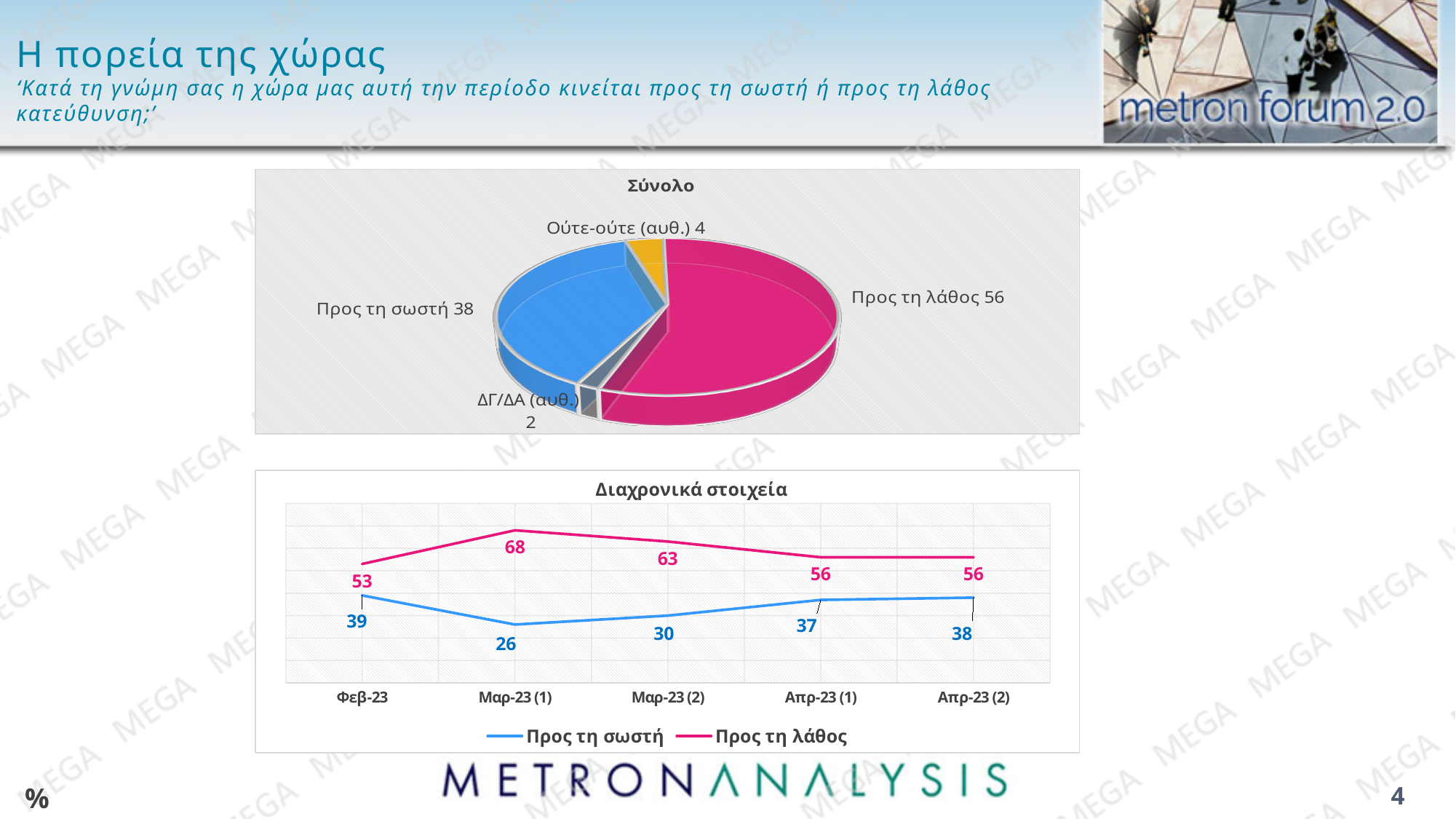
In the 'Διαχρονικά στοιχεία' chart, does 'Προς τη λάθος' rise or fall from Μαρ-23 (1) to Απρ-23 (2)? Fall In the 'Διαχρονικά στοιχεία' chart, what is the value for 'Προς τη λάθος' at Μαρ-23 (1)? 68 What kind of chart is the 'Διαχρονικά στοιχεία' chart? Line chart In the 'Διαχρονικά στοιχεία' chart, what is the difference between 'Προς τη λάθος' and 'Προς τη σωστή' at Φεβ-23? 14 What kind of chart is the 'Σύνολο' chart? Pie chart In the 'Διαχρονικά στοιχεία' chart, what is the value for 'Προς τη σωστή' at Μαρ-23 (2)? 30 In the 'Σύνολο' chart, which category has the smallest slice? ΔΓ/ΔΑ (αυθ.) In the 'Σύνολο' chart, what is the value for 'Προς τη σωστή'? 38 In the 'Σύνολο' chart, what is the value for 'Προς τη λάθος'? 56 In the 'Διαχρονικά στοιχεία' chart, how many series does the legend list? 2 In the 'Διαχρονικά στοιχεία' chart, at which point is 'Προς τη σωστή' lowest? Μαρ-23 (1) In the 'Σύνολο' chart, how many slices does the pie have? 4